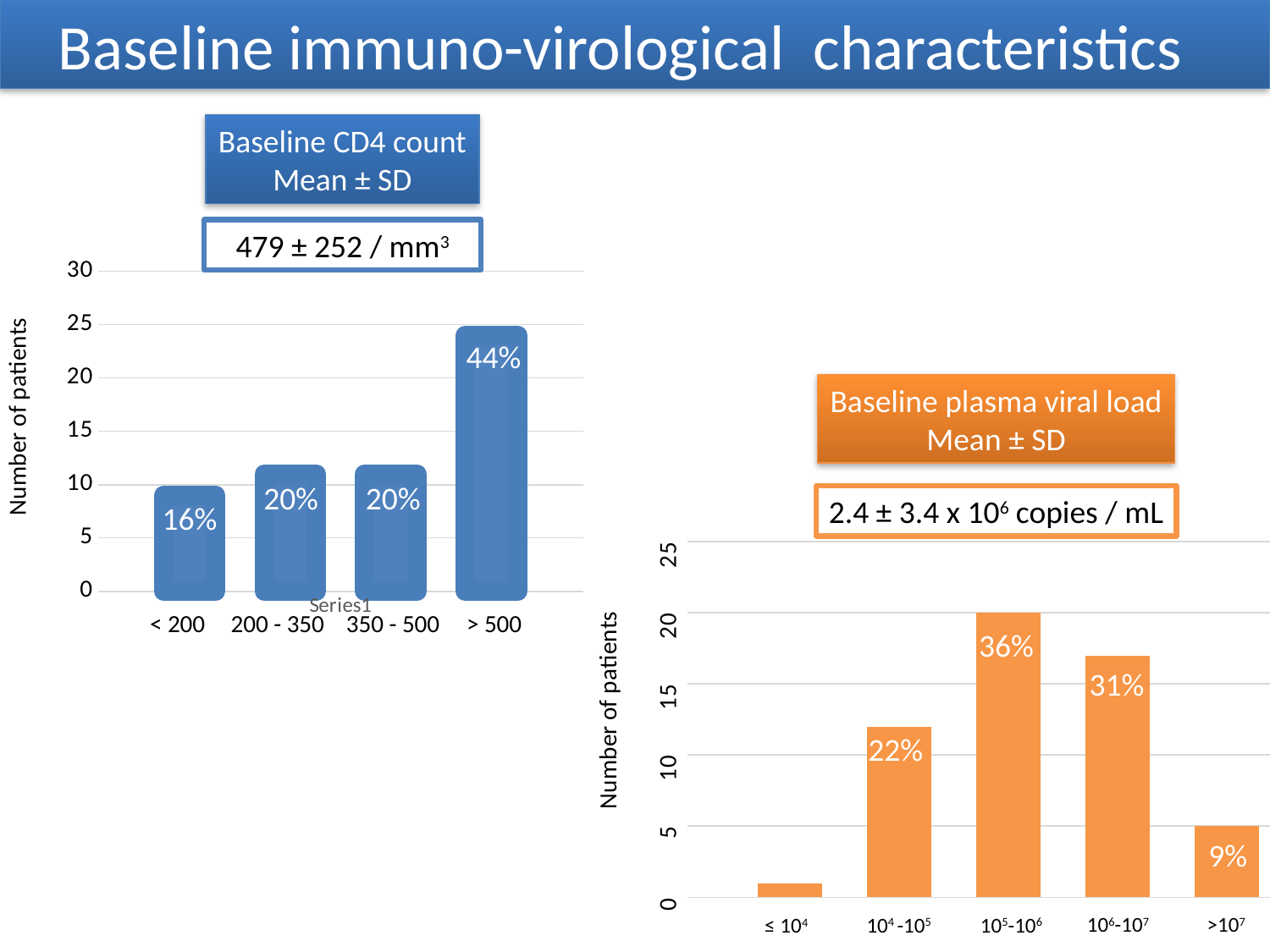
What kind of chart is the Baseline plasma viral load chart? bar chart In the Baseline plasma viral load chart, is the number of patients for 10⁶-10⁷ greater or less than 15? greater In the Baseline CD4 count chart, what is the data label on the > 500 bar? 44% In the Baseline CD4 count chart, what is the data label on the < 200 bar? 16% In the Baseline CD4 count chart, which category has the lowest number of patients? < 200 In the Baseline plasma viral load chart, what is the data label on the 10⁵-10⁶ bar? 36% In the Baseline CD4 count chart, what is the difference between the percentage labels for > 500 and < 200? 28% In the Baseline plasma viral load chart, which category has the highest number of patients? 10⁵-10⁶ In the Baseline CD4 count chart, which category has the highest number of patients? > 500 In the Baseline plasma viral load chart, what is the data label on the >10⁷ bar? 9% How many categories are shown on the x axis of the Baseline CD4 count chart? 4 In the Baseline CD4 count chart, is the number of patients for > 500 greater or less than 20? greater